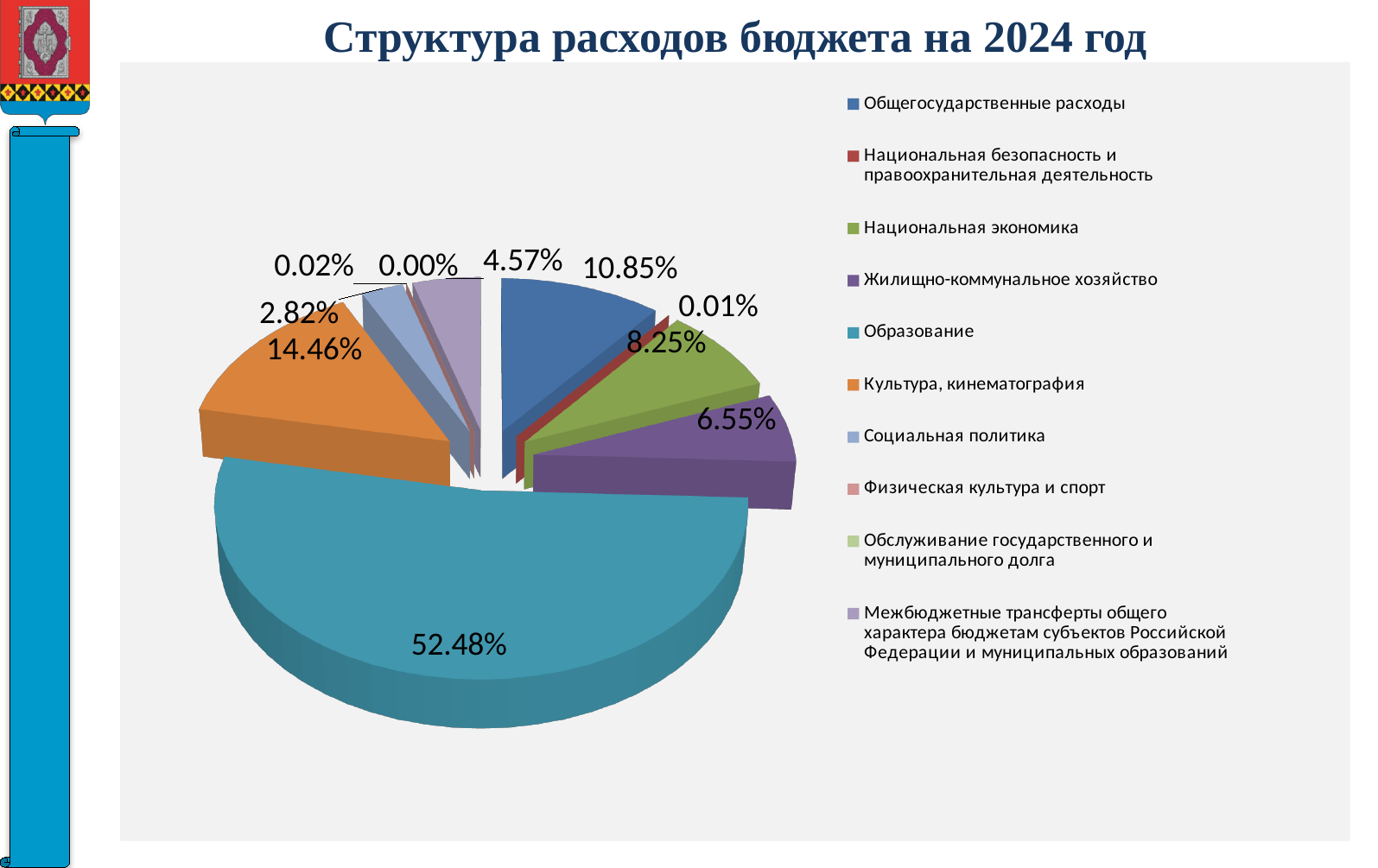
What share is shown for Общегосударственные расходы? 10.85% What share is shown for Социальная политика? 2.82% What share of the budget expenditure goes to Образование? 52.48% How many categories does the legend list? 10 Which is larger: the share for Национальная экономика or the share for Жилищно-коммунальное хозяйство? Национальная экономика What share is shown for Жилищно-коммунальное хозяйство? 6.55% What is the difference between the shares for Образование and Культура, кинематография? 38.02% What share is shown for Культура, кинематография? 14.46% What kind of chart is shown on the slide? pie chart Which category has the smallest share, shown as 0.00%? Обслуживание государственного и муниципального долга What share is shown for Национальная экономика? 8.25% Which category has the largest share of the budget expenditure? Образование